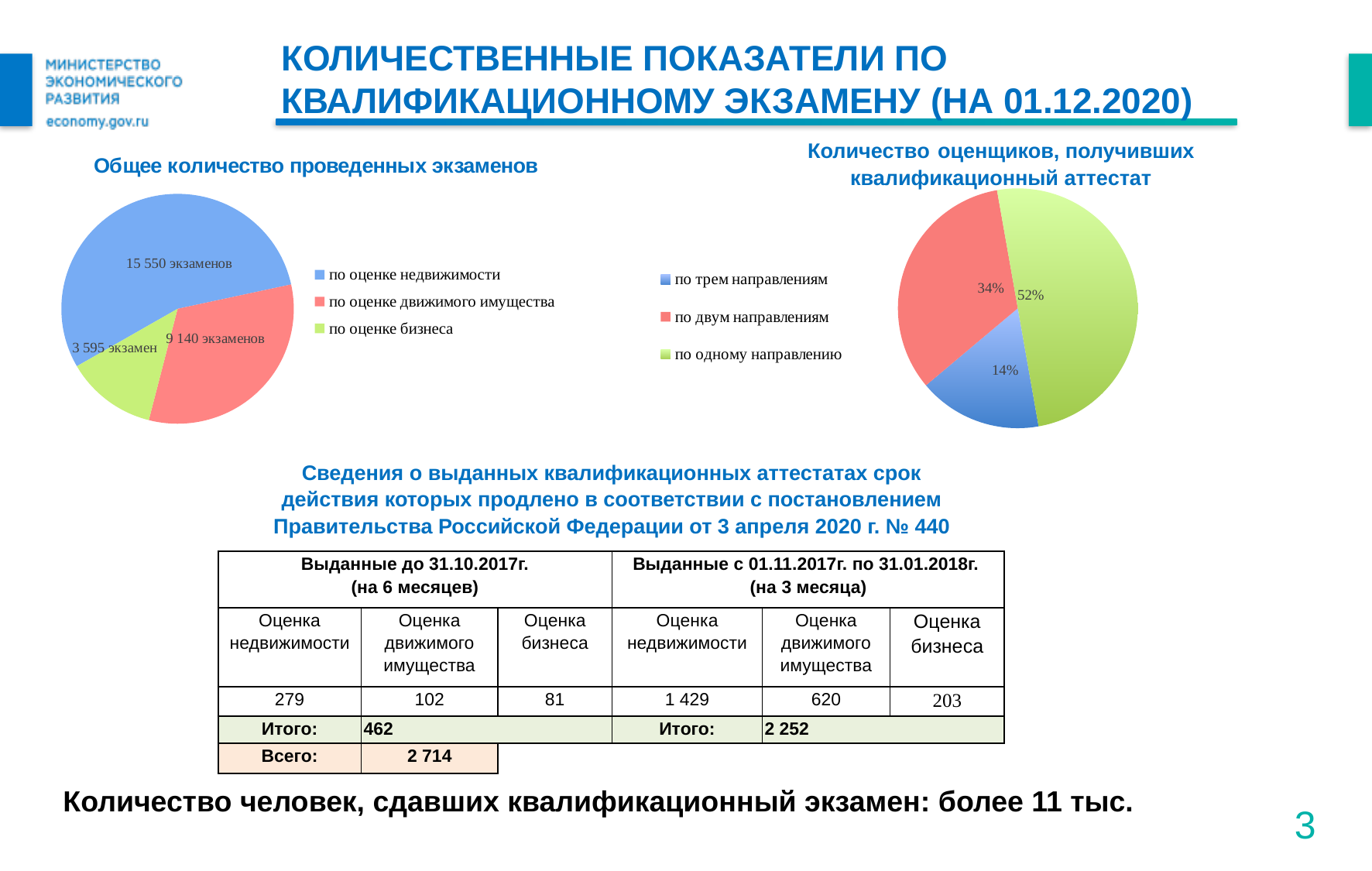
In the chart 'Общее количество проведенных экзаменов', which category has the smallest slice? по оценке бизнеса In the chart 'Количество оценщиков, получивших квалификационный аттестат', what share is shown for 'по трем направлениям'? 14% In the chart 'Количество оценщиков, получивших квалификационный аттестат', which category has the largest share? по одному направлению In the chart 'Количество оценщиков, получивших квалификационный аттестат', what colour is the slice for 'по двум направлениям'? Red In the chart 'Общее количество проведенных экзаменов', what value is shown for 'по оценке движимого имущества'? 9 140 экзаменов In the chart 'Общее количество проведенных экзаменов', what is the difference between the values for 'по оценке недвижимости' and 'по оценке движимого имущества'? 6 410 In the chart 'Количество оценщиков, получивших квалификационный аттестат', what share is shown for 'по одному направлению'? 52% In the chart 'Количество оценщиков, получивших квалификационный аттестат', which is larger: 'по двум направлениям' or 'по трем направлениям'? по двум направлениям In the chart 'Общее количество проведенных экзаменов', what value is shown for 'по оценке недвижимости'? 15 550 экзаменов What type of chart is 'Общее количество проведенных экзаменов'? Pie chart In the chart 'Общее количество проведенных экзаменов', which category has the largest slice? по оценке недвижимости In the chart 'Общее количество проведенных экзаменов', how many categories does the legend list? 3